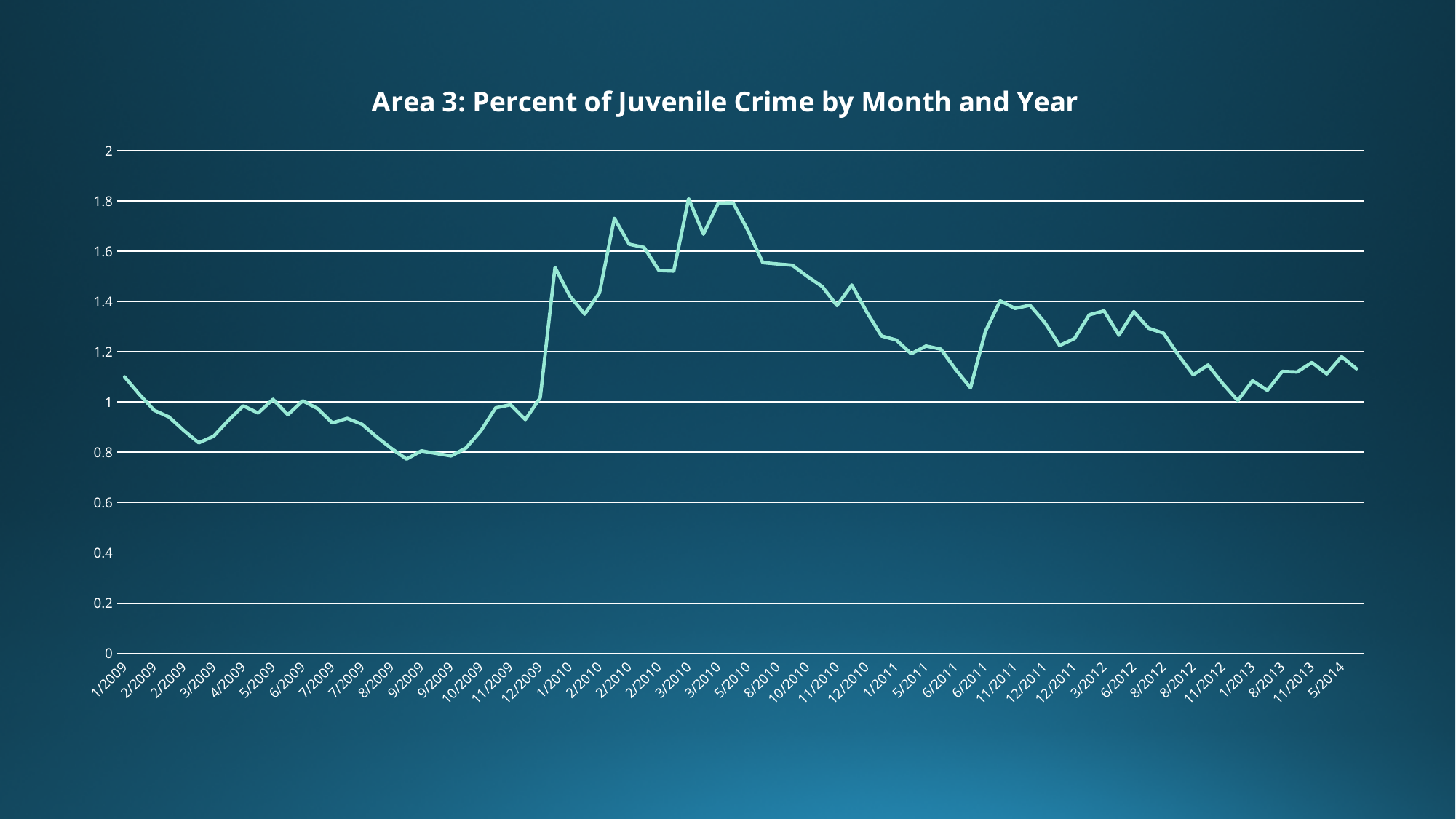
Does the line rise or fall between 5/2010 and 1/2011? fall How many lines (series) are plotted on the chart? 1 Does the line rise or fall between 1/2009 and 3/2009? fall Is the value for 1/2011 greater or less than 1.4? less Is the value for 5/2010 greater or less than 1.6? greater What is the highest value shown on the y axis? 2 What kind of chart is shown on the slide? line chart Is the value for 5/2014 greater or less than 1? greater What is the title of the chart? Area 3: Percent of Juvenile Crime by Month and Year In which year does the line reach its highest point? 2010